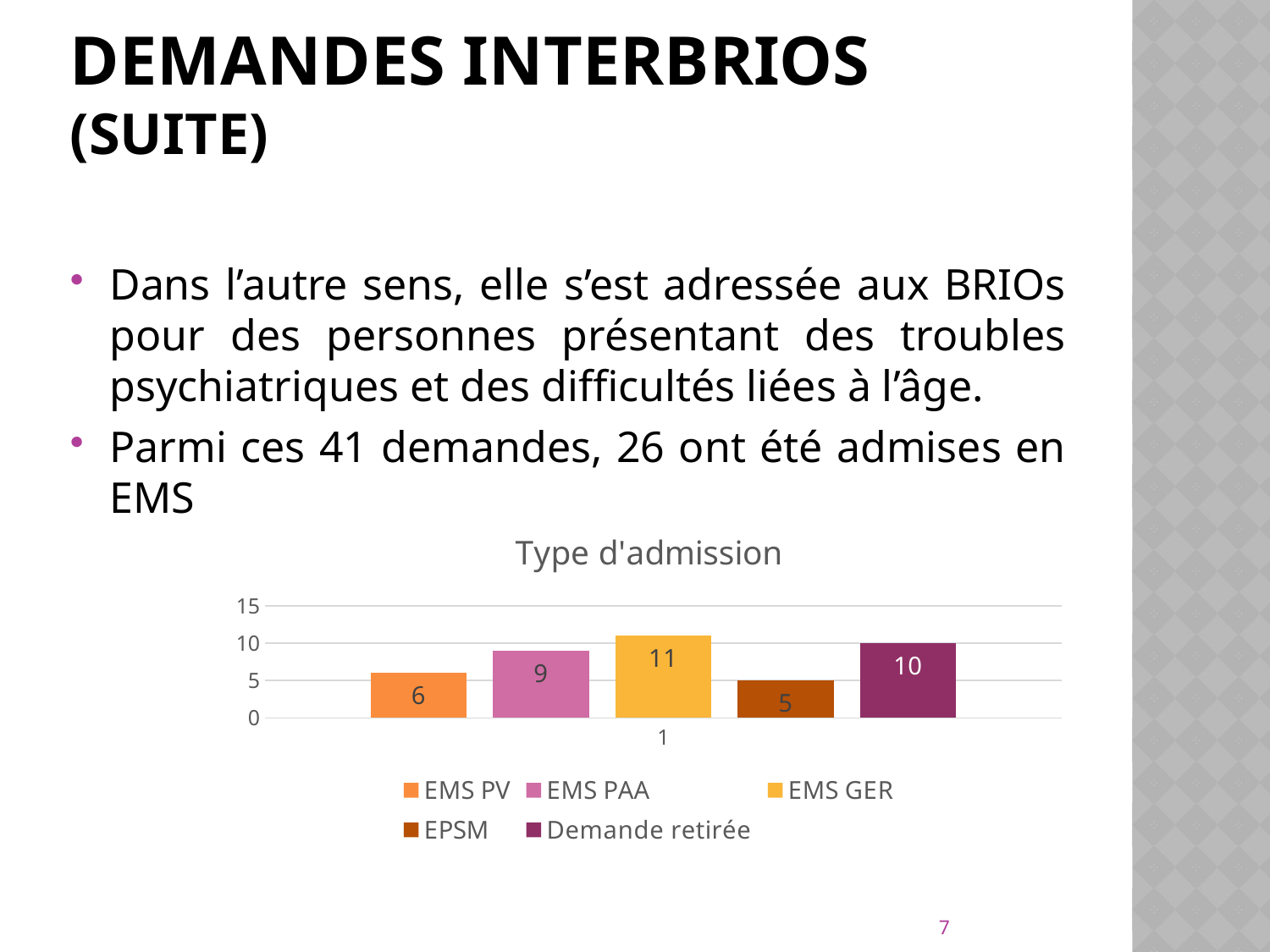
What kind of chart is 'Type d'admission'? bar chart Which is larger in the 'Type d'admission' chart, EMS PAA or EMS PV? EMS PAA What is the value for EMS PV in the 'Type d'admission' chart? 6 What is the value for Demande retirée in the 'Type d'admission' chart? 10 What is the value for EPSM in the 'Type d'admission' chart? 5 How many series does the legend of the 'Type d'admission' chart list? 5 Which series has the lowest value in the 'Type d'admission' chart? EPSM What is the difference between the EMS GER and EPSM values in the 'Type d'admission' chart? 6 Which series has the highest value in the 'Type d'admission' chart? EMS GER What is the difference between the Demande retirée and EMS PAA values in the 'Type d'admission' chart? 1 What is the value for EMS GER in the 'Type d'admission' chart? 11 What is the title of the chart on the slide? Type d'admission